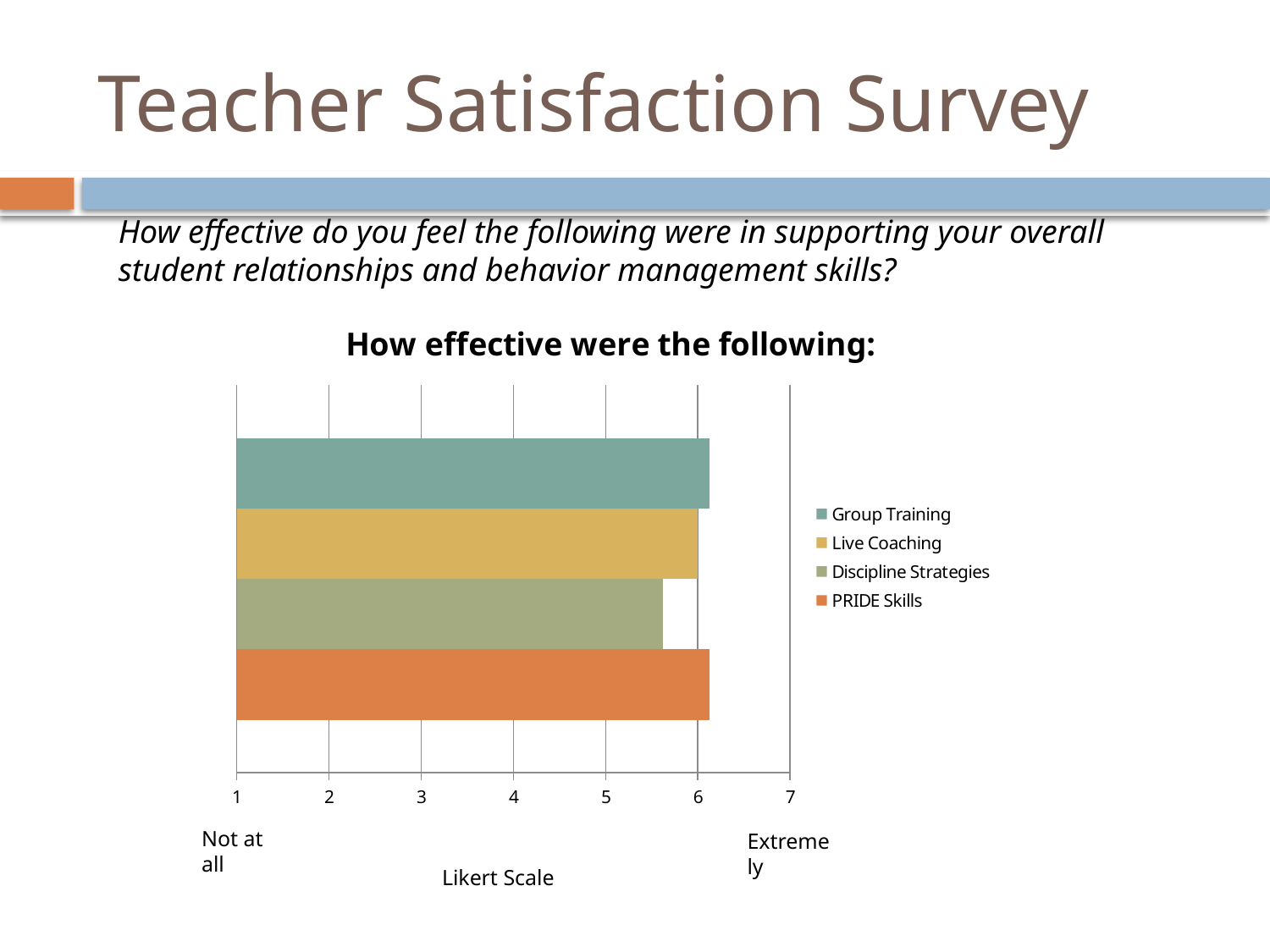
How many bars are plotted in the chart? 4 Is the value for Discipline Strategies greater or less than 6? less Which series has the lowest value? Discipline Strategies Is the value for Group Training greater or less than 5? greater Is the value for PRIDE Skills greater or less than 5? greater How many series does the legend list? 4 What kind of chart is shown on the slide? bar chart What is the title of the chart? How effective were the following: Which is larger, the value for Live Coaching or the value for Discipline Strategies? Live Coaching Which is larger, the value for Group Training or the value for Discipline Strategies? Group Training What is the label of the horizontal axis? Likert Scale